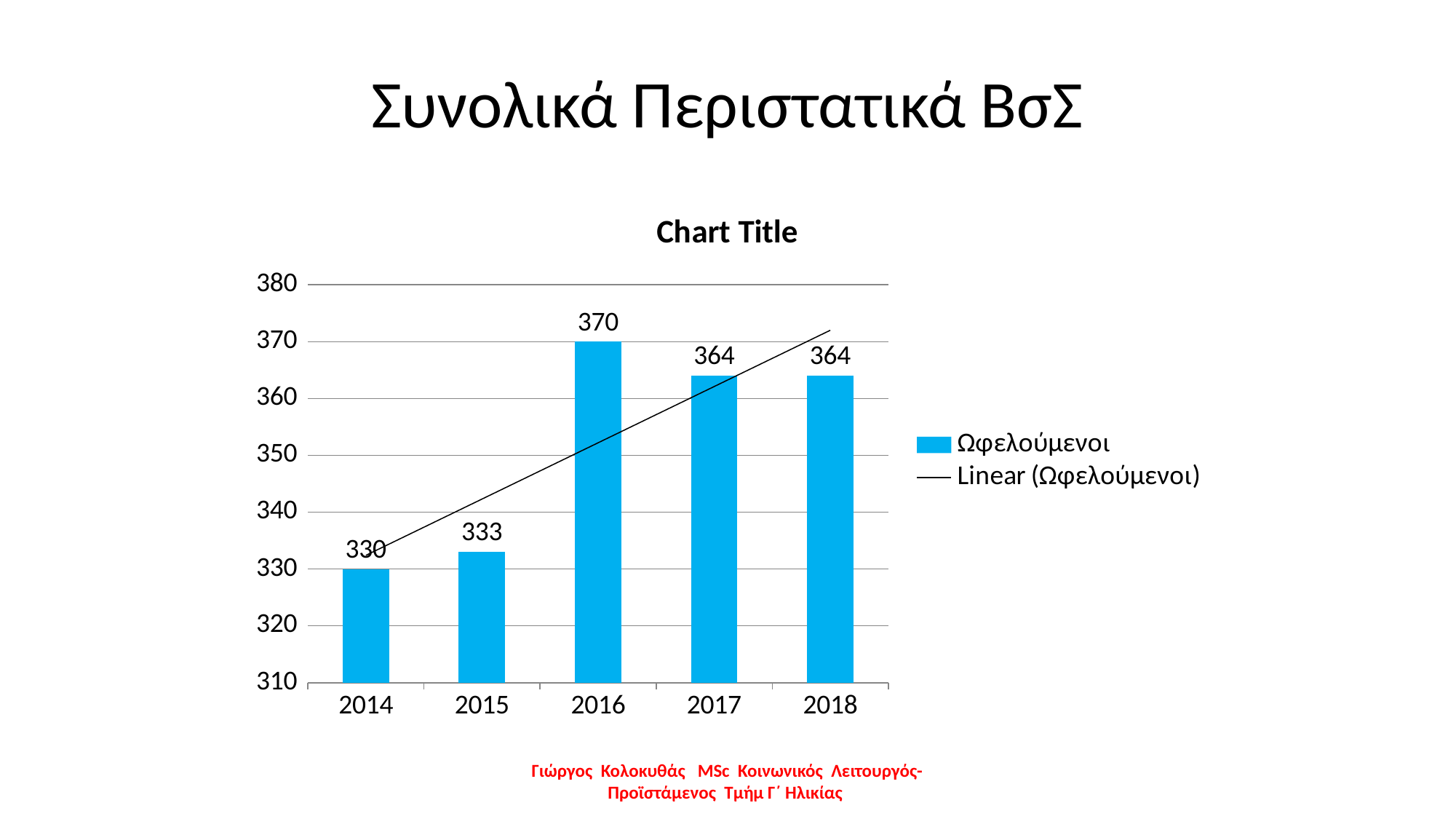
What is the value for 2016? 370 Is the value for 2016 greater or less than 360? greater What is the difference between the values for 2017 and 2015? 31 What is the value for 2015? 333 What is the difference between the values for 2016 and 2014? 40 How many years are shown on the x axis? 5 Which year has the lowest value? 2014 Which year has the highest value? 2016 What kind of chart is shown? bar chart Which is larger, the value for 2015 or the value for 2018? 2018 What is the name of the series shown as bars in the legend? Ωφελούμενοι What is the value for 2014? 330